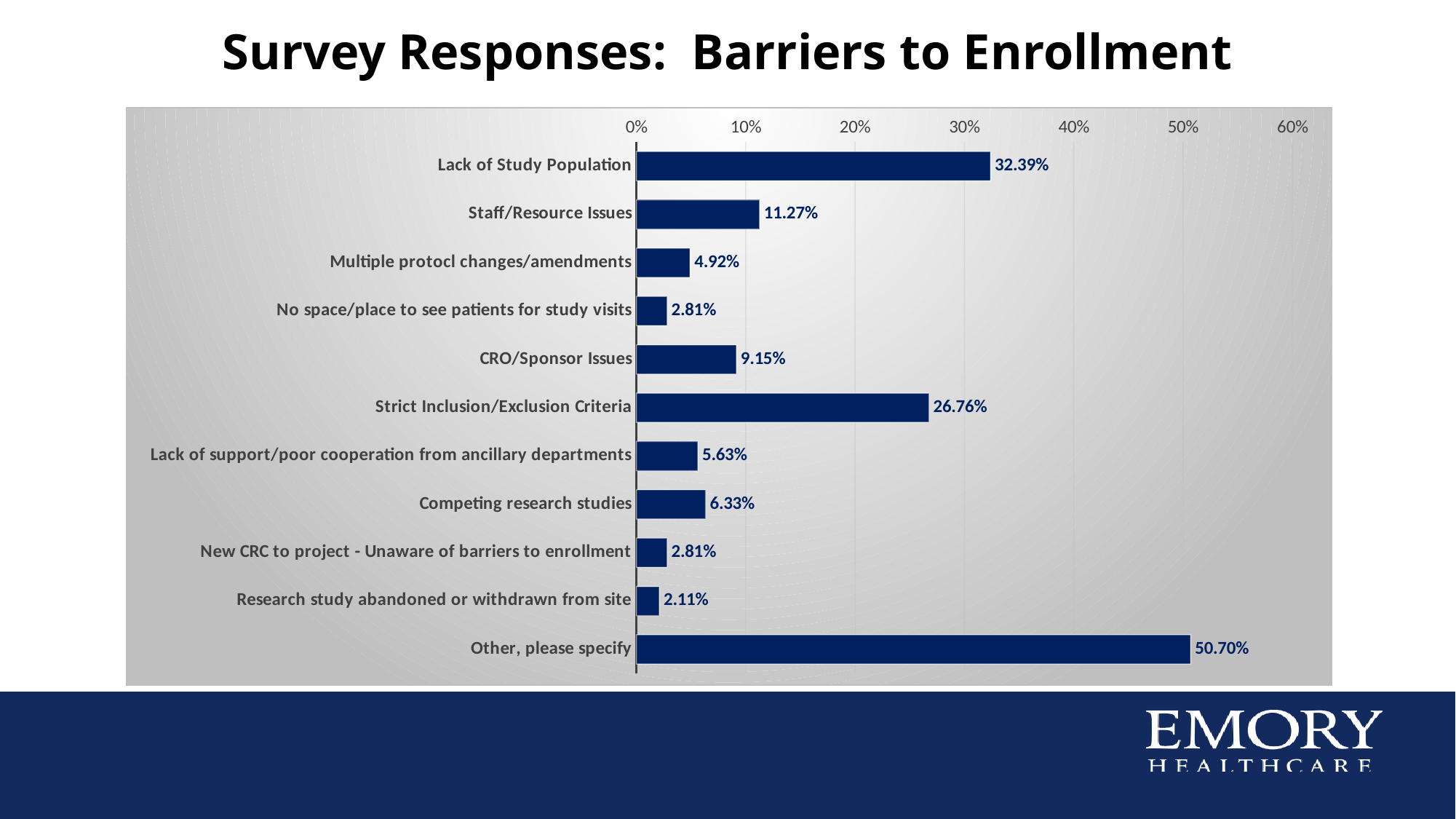
Which category has the lowest value? Research study abandoned or withdrawn from site Is the value for Other, please specify greater or less than 50%? greater Which is larger, Staff/Resource Issues or CRO/Sponsor Issues? Staff/Resource Issues What is the value for Lack of Study Population? 32.39% What is the value for Strict Inclusion/Exclusion Criteria? 26.76% What is the difference between Lack of Study Population and Strict Inclusion/Exclusion Criteria? 5.63% What is the value for Competing research studies? 6.33% Which category has the highest value? Other, please specify What kind of chart is shown on the slide? Bar chart What is the title of the slide? Survey Responses: Barriers to Enrollment What is the value for CRO/Sponsor Issues? 9.15% How many categories are shown in the chart? 11